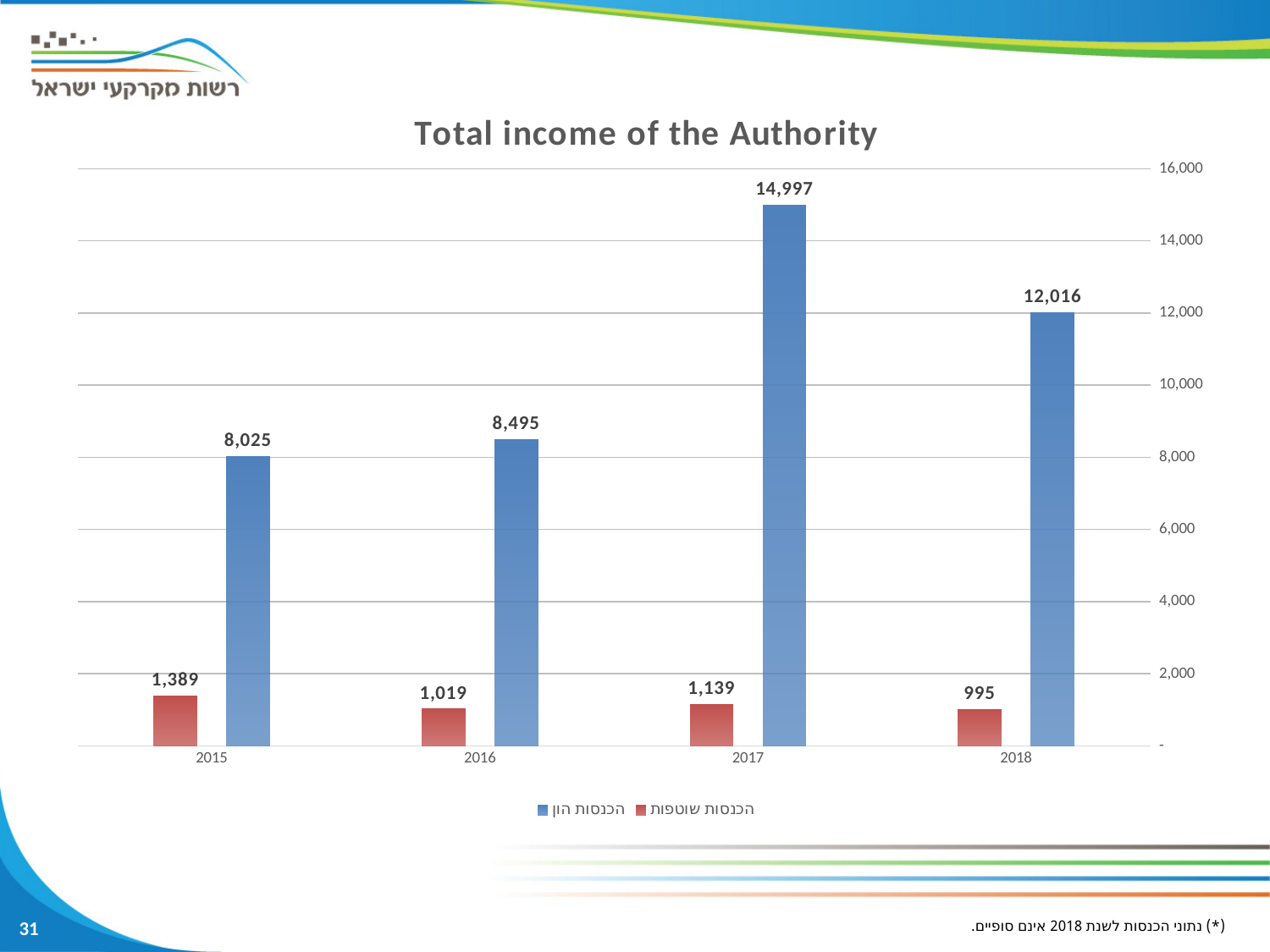
What is the title of the chart? Total income of the Authority How many series does the legend list? 2 Is the value of the blue bar for 2018 greater or less than 10,000? greater What is the value of the blue bar for 2018? 12,016 Which year has the highest blue bar? 2017 How many years are shown on the x axis? 4 What type of chart is shown on the slide? bar chart What is the difference between the blue bar values for 2017 and 2018? 2,981 What is the value of the red bar for 2015? 1,389 What is the value of the blue bar for 2017? 14,997 Which is larger, the blue bar for 2015 or the blue bar for 2016? 2016 Which year has the lowest red bar? 2018